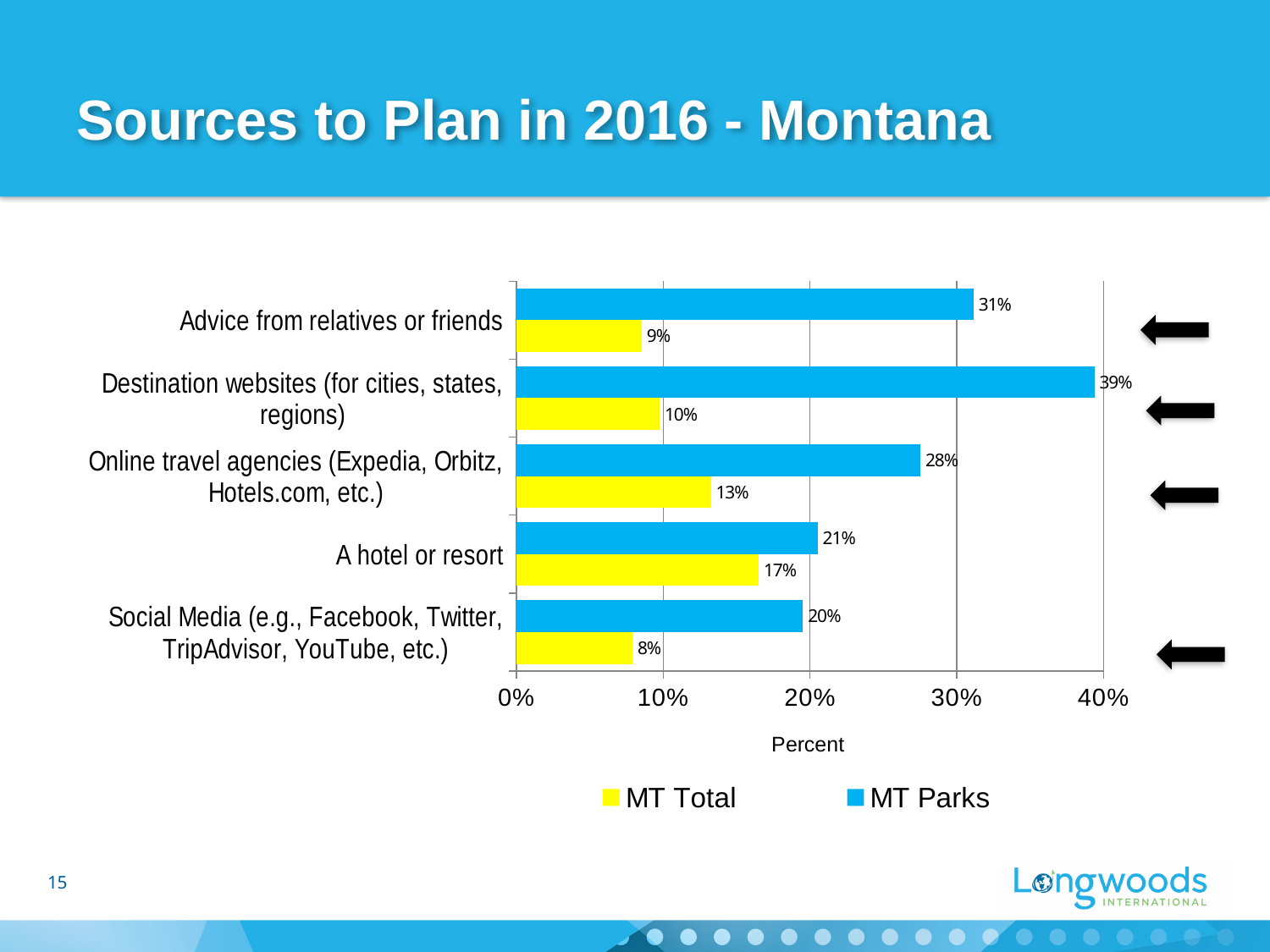
What kind of chart is shown on the slide? Bar chart What colour represents the MT Total series? Yellow Which category has the lowest MT Total value? Social Media (e.g., Facebook, Twitter, TripAdvisor, YouTube, etc.) What is the MT Parks value for Social Media (e.g., Facebook, Twitter, TripAdvisor, YouTube, etc.)? 20% How many categories are shown on the chart? 5 What is the MT Parks value for Destination websites (for cities, states, regions)? 39% Which category has the highest MT Parks value? Destination websites (for cities, states, regions) What is the MT Total value for A hotel or resort? 17% Is the MT Parks value for Online travel agencies (Expedia, Orbitz, Hotels.com, etc.) greater or less than 20%? greater Which is larger for Online travel agencies (Expedia, Orbitz, Hotels.com, etc.): the MT Parks value or the MT Total value? MT Parks How many series does the legend list? 2 What is the difference between the MT Parks and MT Total values for Advice from relatives or friends? 22%